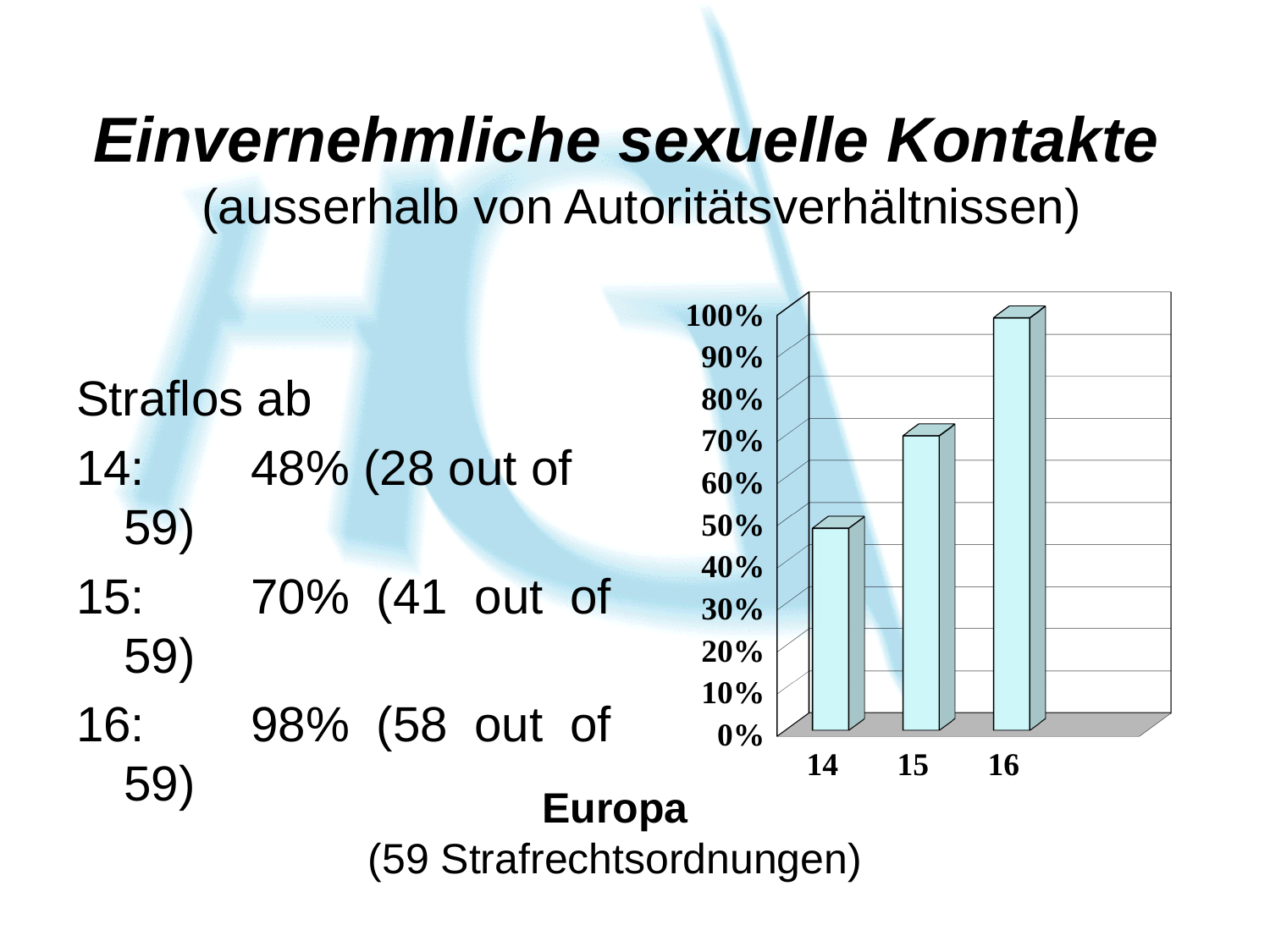
Which age category has the lowest bar in the chart? 14 Which is larger, the value for age 15 or the value for age 16? 16 What is the difference between the values for age 16 and age 14? 50% What is the value for age 14 in the chart? 48% Which age category has the highest bar in the chart? 16 What kind of chart is shown on the slide? bar chart Is the value for age 14 greater or less than 50%? less Do the values rise or fall as the age increases along the x axis? rise How many bars does the chart show? 3 Is the value for age 16 greater or less than 90%? greater What is the value for age 15 in the chart? 70% What is the value for age 16 in the chart? 98%